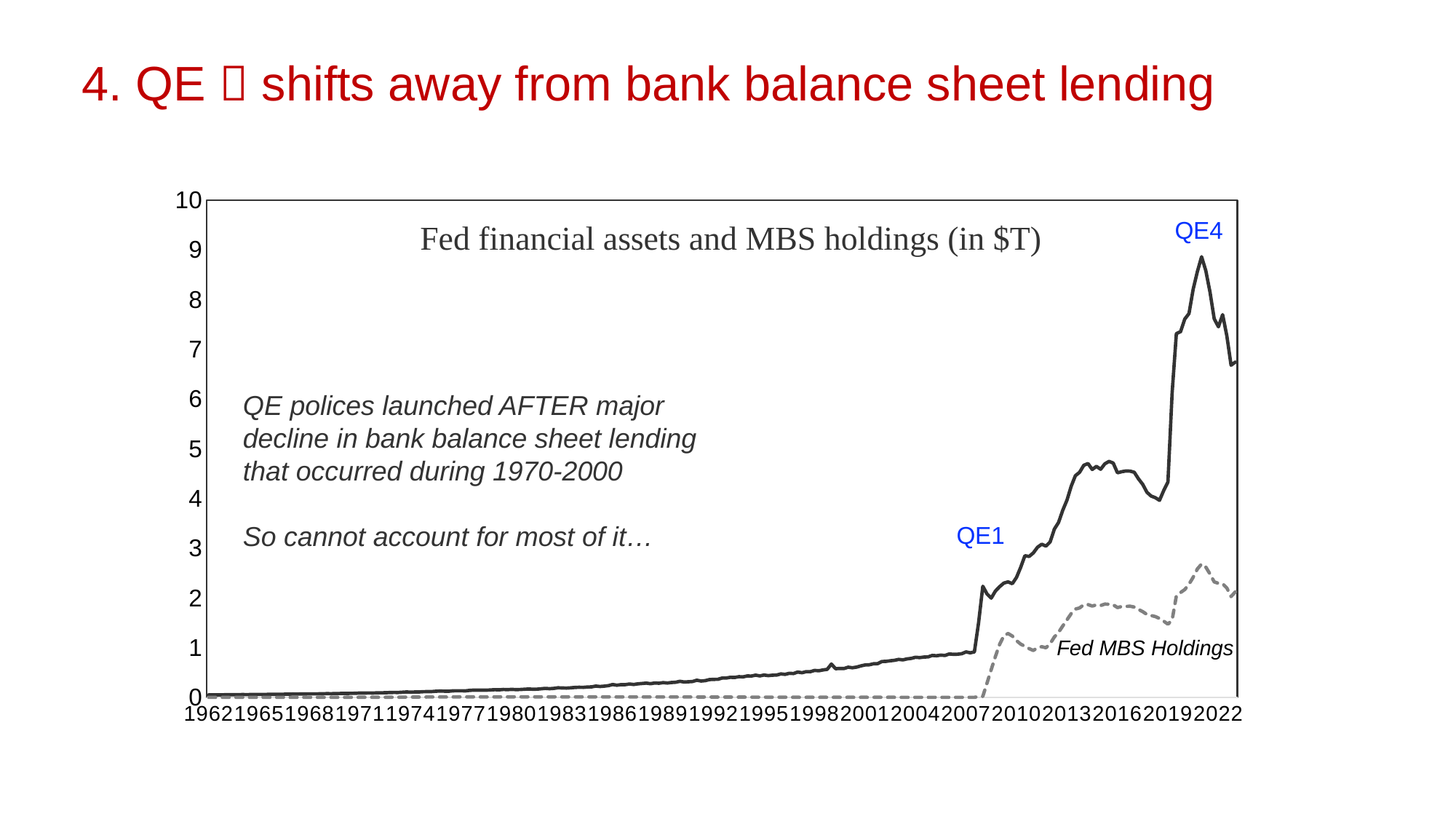
Is the value of Fed financial assets in 2013 greater or less than 3? greater What is the maximum value shown on the y axis? 10 Is the value of Fed financial assets in 1962 greater or less than 1? less Is the peak value of the Fed MBS Holdings line greater or less than 2? greater What kind of chart is shown on the slide? line chart How many data series are plotted in the chart? 2 What is the title of the chart? Fed financial assets and MBS holdings (in $T) Do Fed financial assets generally rise or fall from 1962 to 2022? rise Which two QE episodes are labelled on the chart? QE1 and QE4 Which line is higher in 2022, Fed financial assets or Fed MBS Holdings? Fed financial assets What is the first year shown on the x axis? 1962